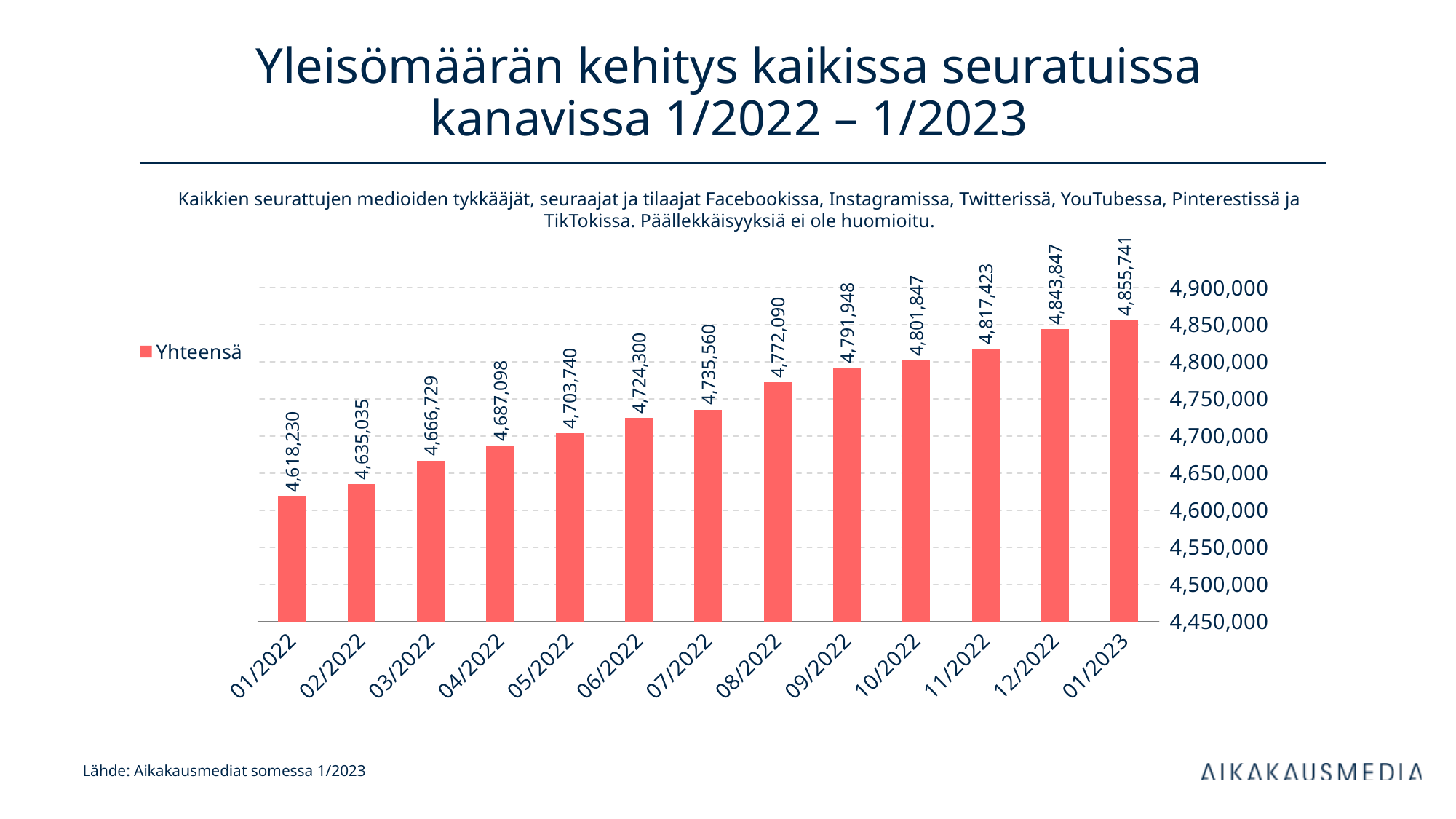
What is the value for 01/2022? 4,618,230 What is the difference between the values for 01/2023 and 01/2022? 237,511 What is the value for 01/2023? 4,855,741 What kind of chart is shown on the slide? bar chart How many months are shown on the x axis? 13 What is the difference between the values for 12/2022 and 11/2022? 26,424 Which month has the highest value? 01/2023 What is the value for 08/2022? 4,772,090 Do the values rise or fall from 01/2022 to 01/2023? rise Is the value for 06/2022 greater or less than 4,700,000? greater Which is larger, the value for 05/2022 or the value for 09/2022? 09/2022 Which month has the lowest value? 01/2022